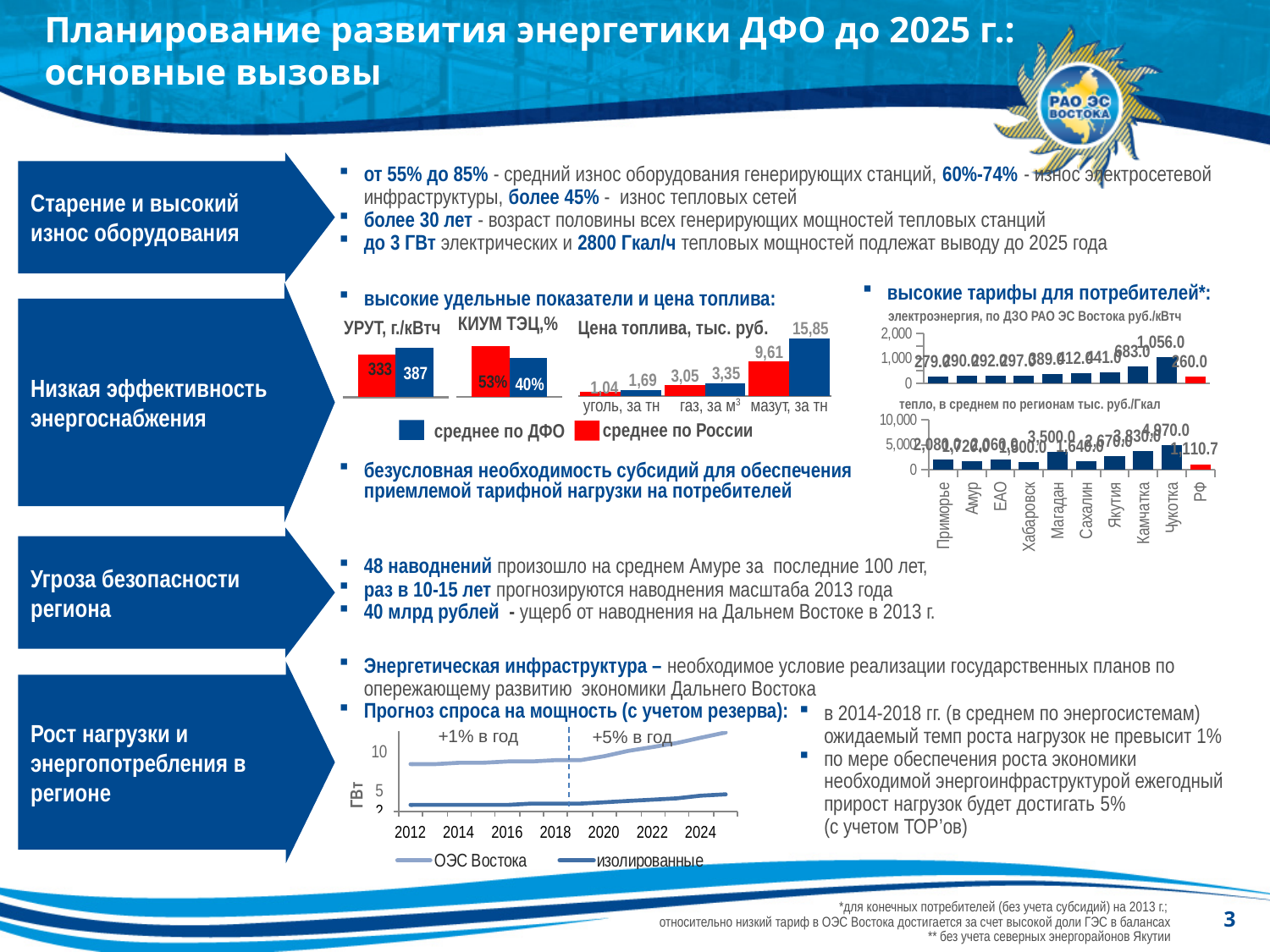
In the 'Прогноз спроса на мощность' line chart, does the ОЭС Востока line rise or fall from 2012 to 2024? rise How many fuel categories are shown in the 'Цена топлива, тыс. руб.' chart? 3 In the 'КИУМ ТЭЦ,%' chart, what is the value for среднее по России? 53% In the 'УРУТ, г./кВтч' chart, what is the value for среднее по ДФО? 387 What kind of chart is the 'УРУТ, г./кВтч' chart? bar chart In the 'электроэнергия, по ДЗО РАО ЭС Востока руб./кВтч' chart, which region has the highest value? Чукотка In the 'электроэнергия, по ДЗО РАО ЭС Востока руб./кВтч' chart, what is the value for РФ? 260.0 In the 'Прогноз спроса на мощность' line chart, which series has the higher values, ОЭС Востока or изолированные? ОЭС Востока In the 'Цена топлива, тыс. руб.' chart, what is the difference between the ДФО and Россия prices for мазут, за тн? 6,24 In the 'Цена топлива, тыс. руб.' chart, what is the price of мазут, за тн for среднее по ДФО? 15,85 How many series does the legend under the 'Цена топлива' chart list? 2 In the 'тепло, в среднем по регионам тыс. руб./Гкал' chart, what is the value for Чукотка? 4,970.0